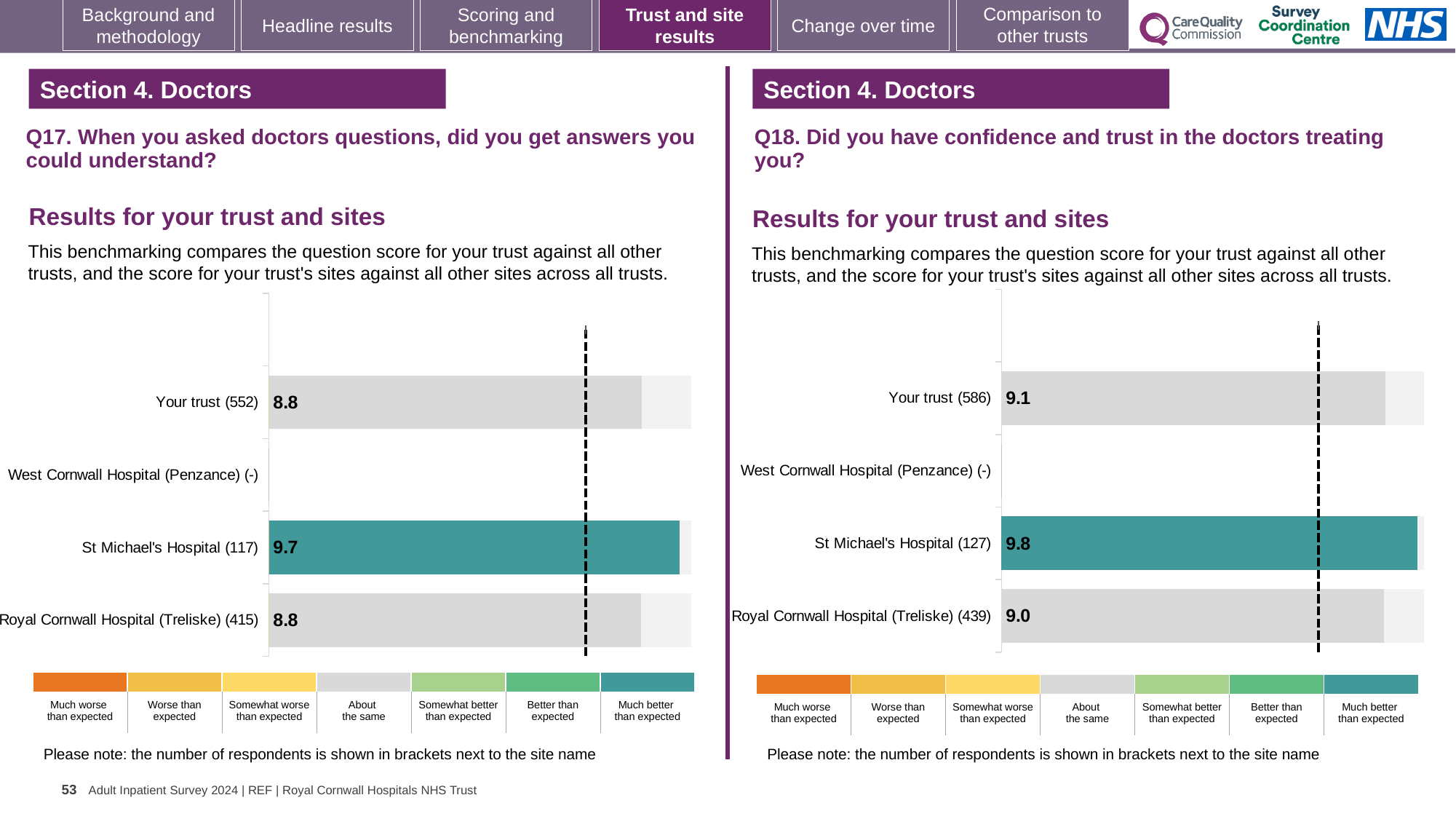
On the Q17 chart, what is the score for St Michael's Hospital? 9.7 On the Q18 chart, how many respondents are shown in brackets for St Michael's Hospital? 127 On the Q17 chart, how many rows (trust and sites) are listed on the vertical axis? 4 On the Q18 chart, what is the score for Royal Cornwall Hospital (Treliske)? 9.0 What kind of chart is used on the Q17 side of the slide? Bar chart On the Q17 chart, what is the difference between the scores for St Michael's Hospital and Your trust? 0.9 On the Q18 chart, which row has the lowest score? Royal Cornwall Hospital (Treliske) On the Q17 chart, what is the score for Your trust? 8.8 On the Q18 chart, what is the score for Your trust? 9.1 On the Q18 chart, which is higher: the score for Your trust or for Royal Cornwall Hospital (Treliske)? Your trust On the Q17 chart, which site has the highest score? St Michael's Hospital On the Q18 chart, what is the difference between the scores for St Michael's Hospital and Royal Cornwall Hospital (Treliske)? 0.8